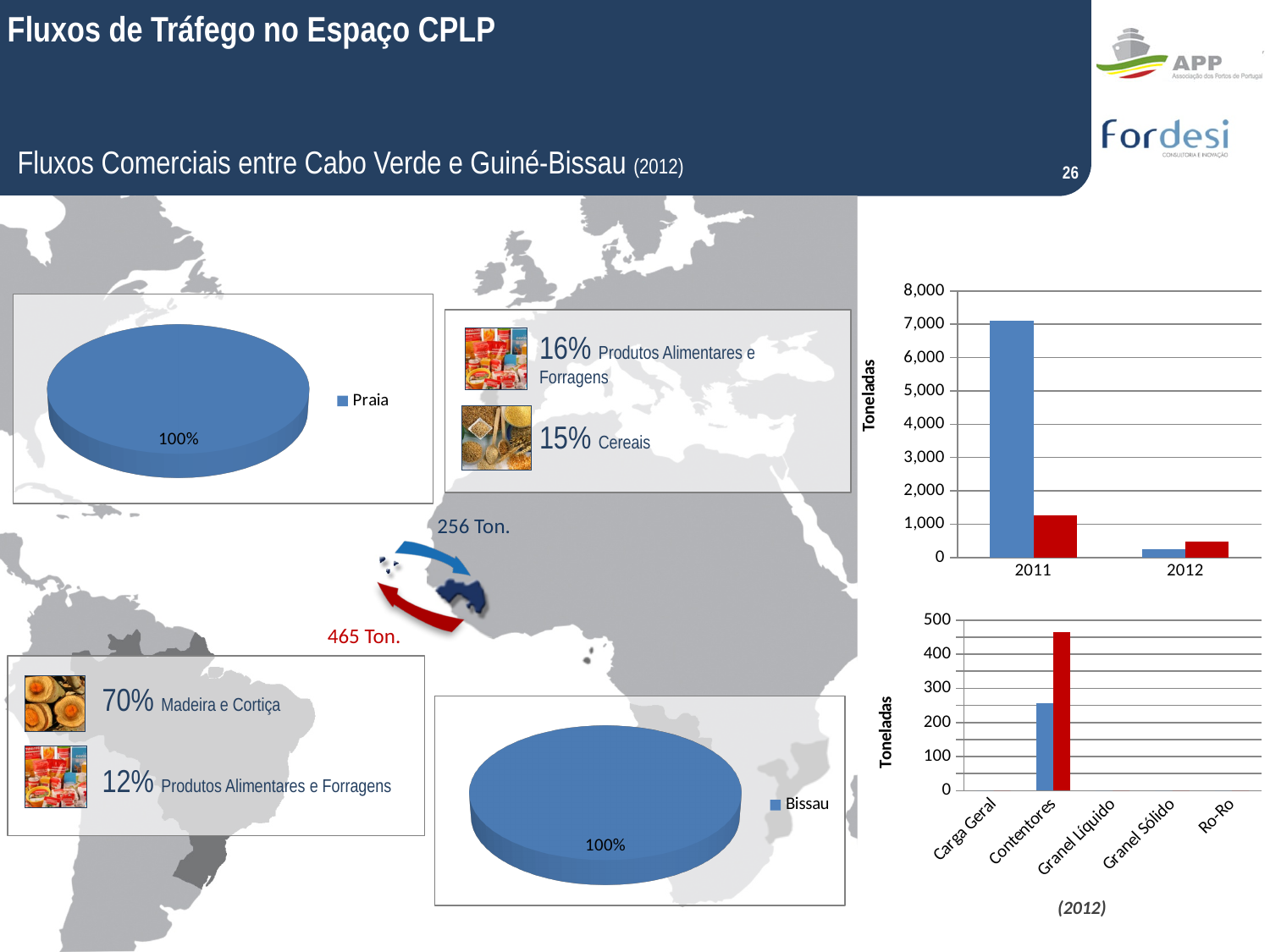
In the top-right bar chart, is the blue bar for 2011 greater or less than 6,000? greater In the bottom-right bar chart, is the red bar for Contentores greater or less than 400? greater In the top-left pie chart, what share is shown for Praia? 100% What kind of chart is the top-left chart with the Praia legend? pie chart In the top-right bar chart, which bar is taller for 2011, the blue one or the red one? the blue one In the top-right bar chart, which year has the tallest bar? 2011 In the top-right bar chart, is the red bar for 2012 greater or less than 1,000? less In the bottom-centre pie chart, what share is shown for Bissau? 100% What kind of chart is the top-right chart with the years 2011 and 2012 on the x axis? bar chart In the bottom-right bar chart, how many cargo categories are shown on the x axis? 5 In the top-right bar chart, how many years are shown on the x axis? 2 In the bottom-right bar chart, which category has the tallest bars? Contentores